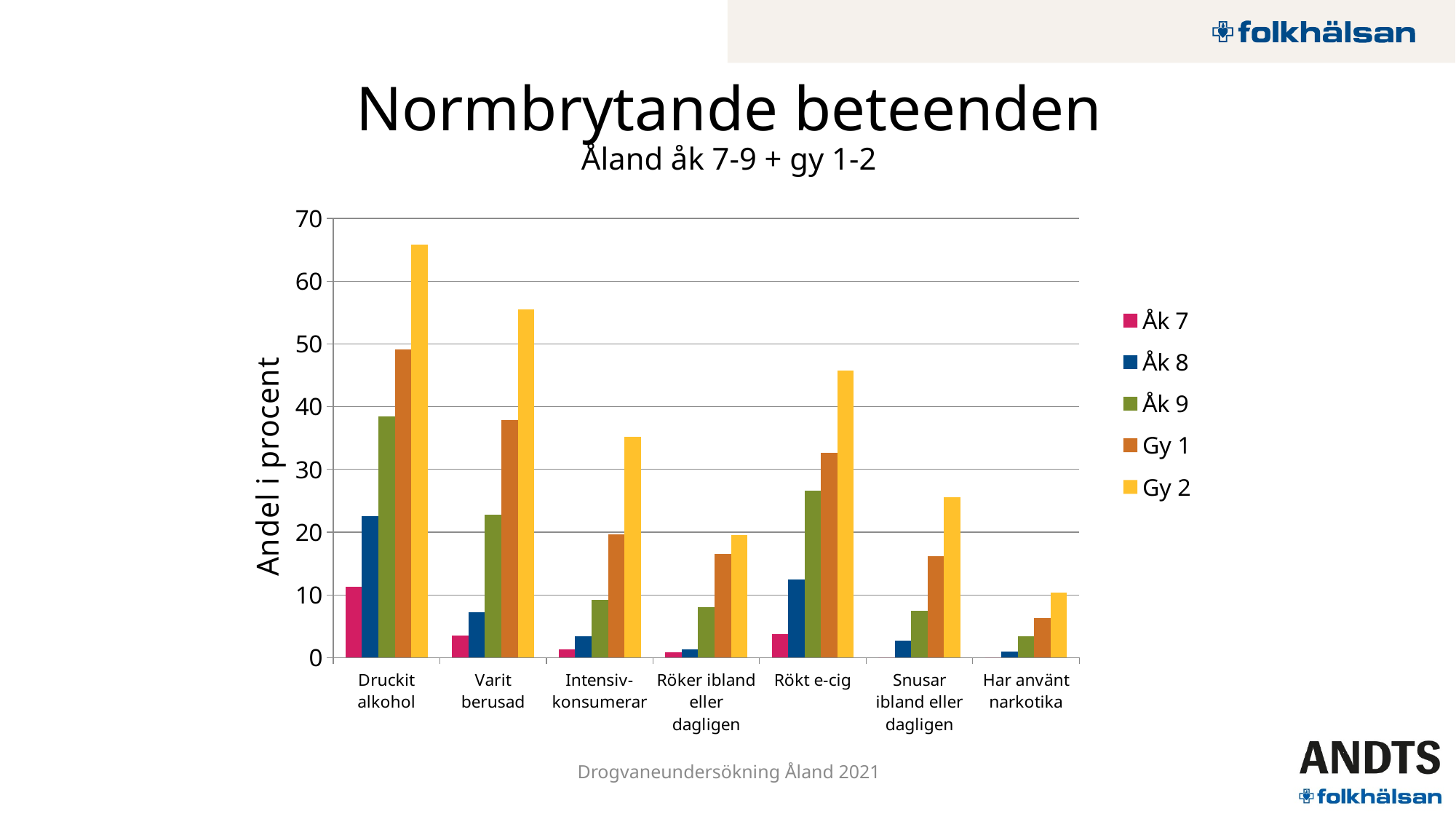
Which series is shown in yellow in the legend? Gy 2 Is the Gy 2 value for Druckit alkohol greater or less than 60? greater How many categories are shown on the x axis of the chart? 7 What kind of chart is shown on the slide? bar chart Is the Åk 9 value for Druckit alkohol greater or less than 40? less What is the y-axis label of the chart? Andel i procent How many series does the legend list? 5 For which category is the Gy 2 value highest? Druckit alkohol Is the Gy 2 value for Varit berusad greater or less than 50? greater Which is larger for Druckit alkohol, the Gy 1 value or the Gy 2 value? Gy 2